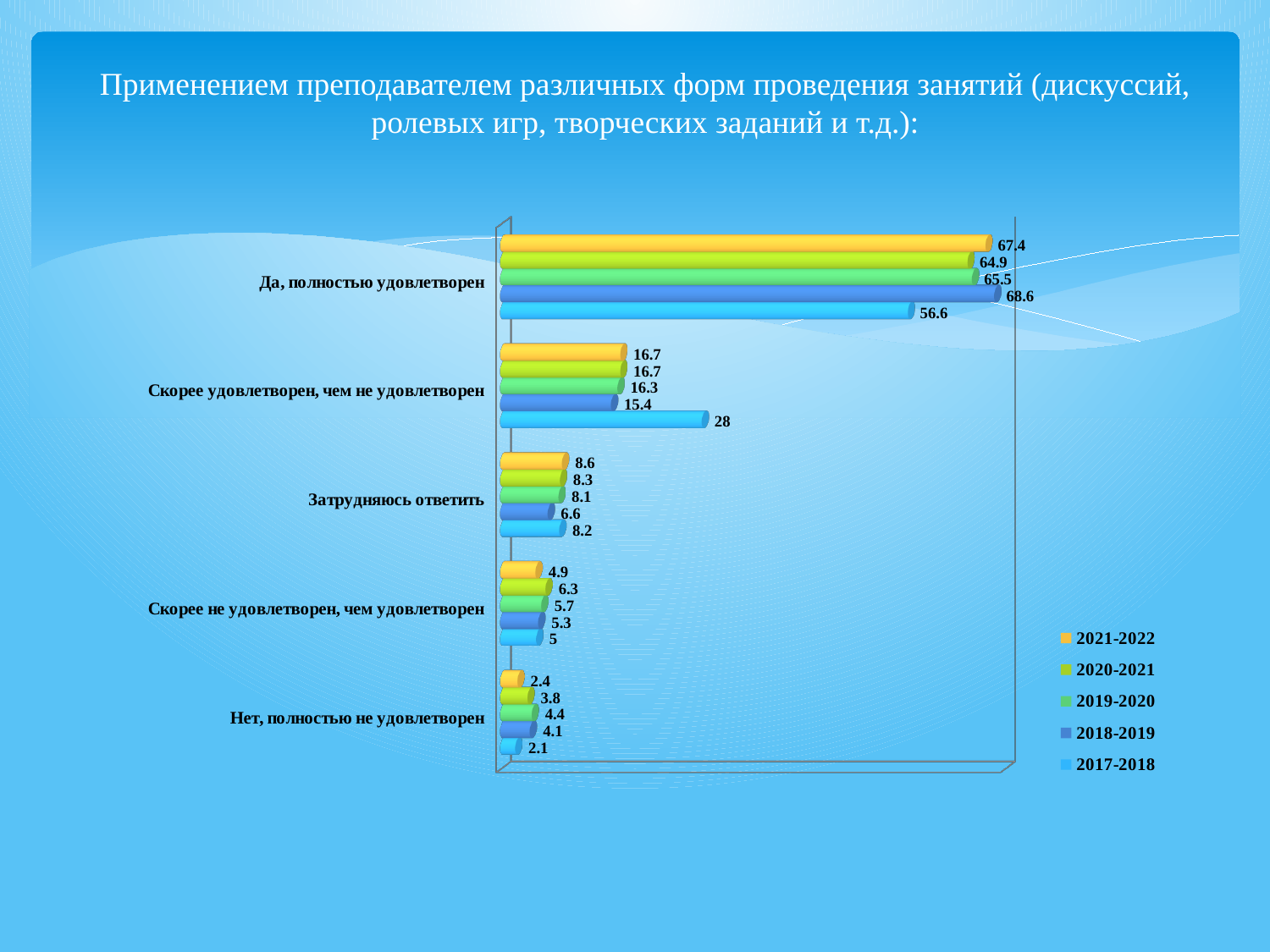
Which series has the lowest value for "Нет, полностью не удовлетворен"? 2017-2018 What is the value for "Нет, полностью не удовлетворен" in the 2019-2020 series? 4.4 What is the value for "Скорее удовлетворен, чем не удовлетворен" in the 2017-2018 series? 28 Which series has the highest value for "Да, полностью удовлетворен"? 2018-2019 What is the value for "Да, полностью удовлетворен" in the 2021-2022 series? 67.4 How many categories are shown on the chart? 5 What is the value for "Затрудняюсь ответить" in the 2018-2019 series? 6.6 How many series does the legend list? 5 What is the difference between the 2018-2019 and 2017-2018 values for "Да, полностью удовлетворен"? 12 Which is larger for "Скорее не удовлетворен, чем удовлетворен": the 2020-2021 value or the 2021-2022 value? 2020-2021 Which legend entry is shown in light blue? 2017-2018 What kind of chart is shown on the slide? Bar chart